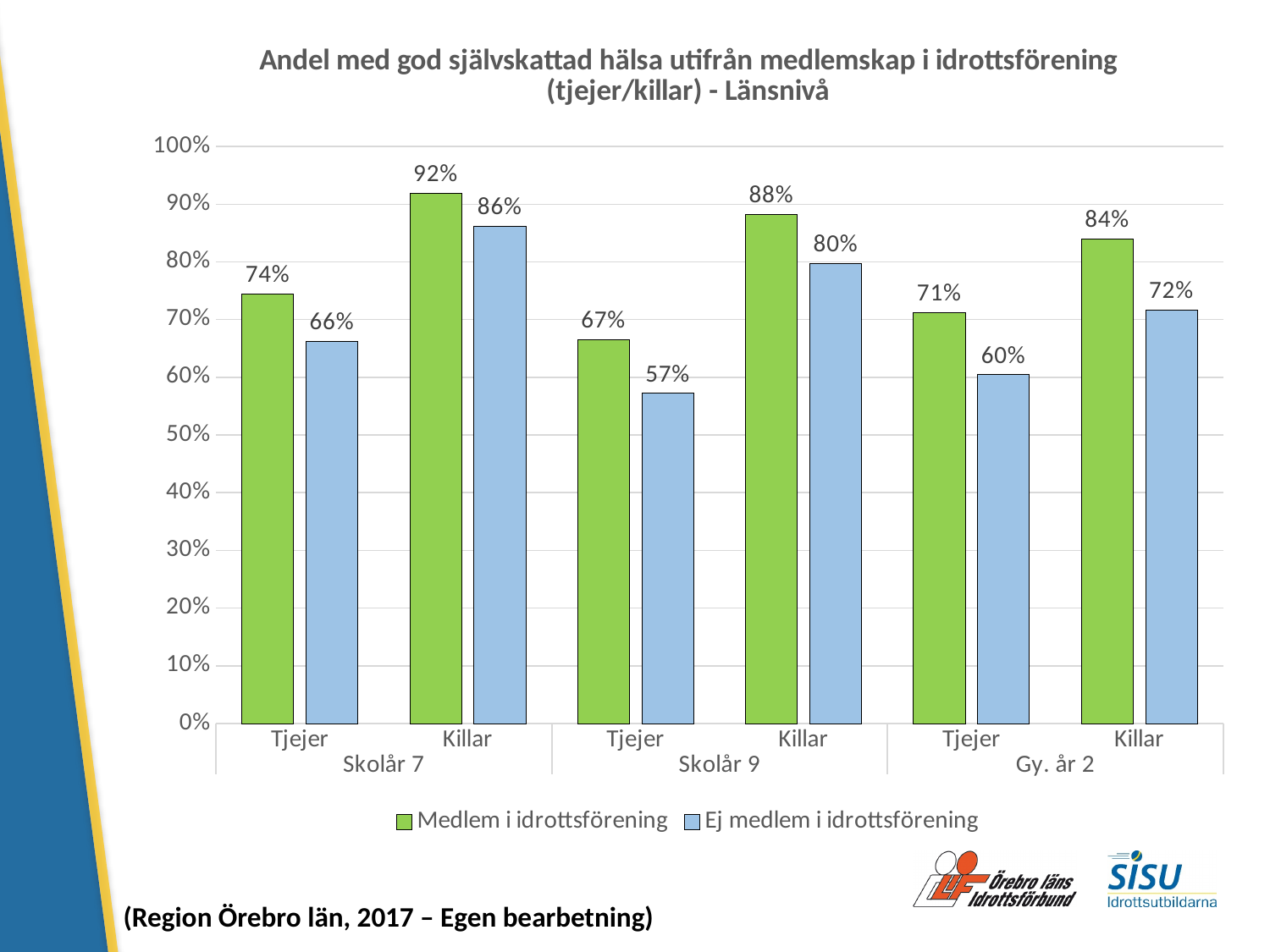
What is the value for Ej medlem i idrottsförening for Tjejer in Skolår 9? 57% Which category has the lowest value for Ej medlem i idrottsförening? Tjejer, Skolår 9 Which category has the highest value for Medlem i idrottsförening? Killar, Skolår 7 Which is larger: Ej medlem i idrottsförening for Killar in Skolår 9 or Medlem i idrottsförening for Tjejer in Skolår 7? Ej medlem i idrottsförening for Killar in Skolår 9 Which colour represents Ej medlem i idrottsförening in the chart? Light blue What is the difference between Medlem i idrottsförening and Ej medlem i idrottsförening for Tjejer in Gy. år 2? 11% What is the value for Medlem i idrottsförening for Killar in Skolår 7? 92% What is the value for Ej medlem i idrottsförening for Killar in Gy. år 2? 72% Is the value for Medlem i idrottsförening for Tjejer in Skolår 9 greater or less than 70%? less How many bars are plotted in the chart? 12 What kind of chart is shown on the slide? Bar chart How many series does the legend list? 2